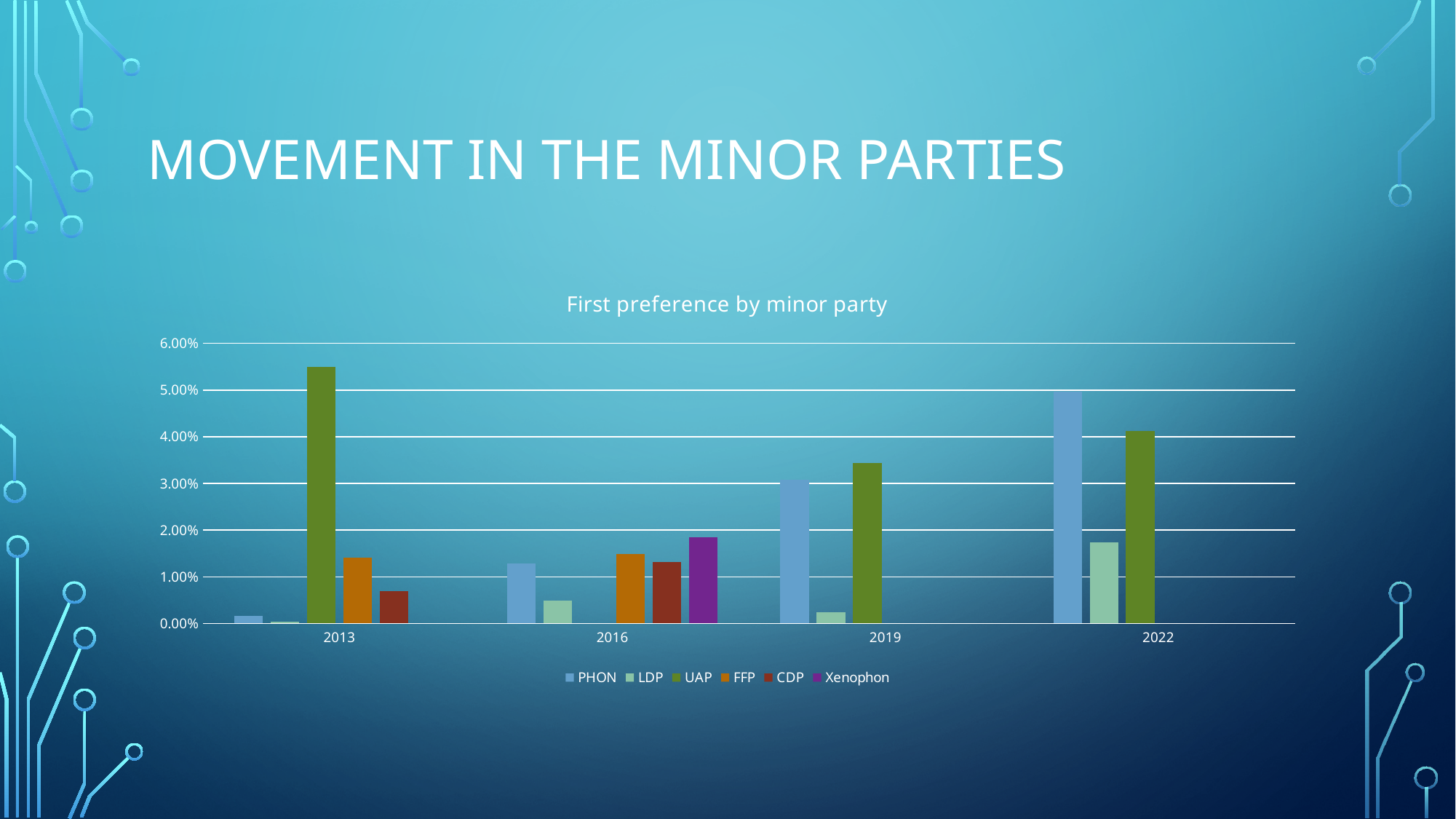
How many years are shown on the x axis? 4 What is the title of the chart? First preference by minor party Is the value for UAP in 2013 greater or less than 5.00%? greater What kind of chart is shown on the slide? bar chart In 2022, which is larger, PHON or UAP? PHON Is the value for PHON in 2019 greater or less than 2.00%? greater In 2019, which is larger, UAP or PHON? UAP Which party has the lowest value in 2013? LDP In which year is the UAP bar the highest? 2013 Does the PHON value rise or fall from 2013 to 2022? rise How many series does the legend list? 6 Is the value for LDP in 2022 greater or less than 1.00%? greater